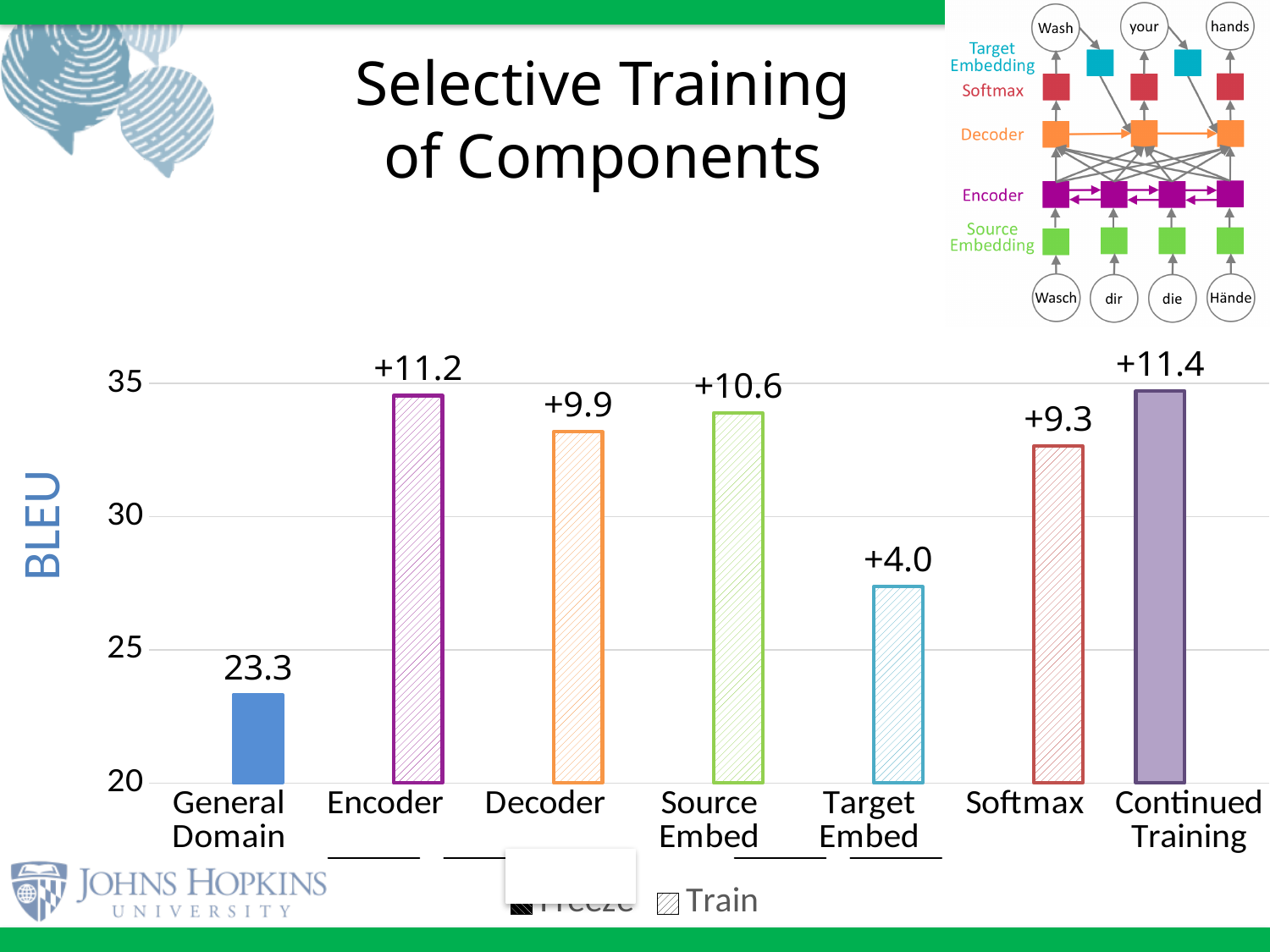
How many categories are shown on the x axis of the chart? 7 Is the value for Target Embed greater or less than 30? less Which bar is taller, Source Embed or Decoder? Source Embed Which of the trained components shows the smallest improvement label? Target Embed What is the BLEU score shown for General Domain? 23.3 What kind of chart is shown on the slide? bar chart Which category has the tallest bar in the chart? Continued Training What improvement label is printed above the Target Embed bar? +4.0 What improvement label is printed above the Continued Training bar? +11.4 What is the difference between the improvement labels for Encoder (+11.2) and Decoder (+9.9)? 1.3 What improvement label is printed above the Encoder bar? +11.2 Which category has the shortest bar in the chart? General Domain